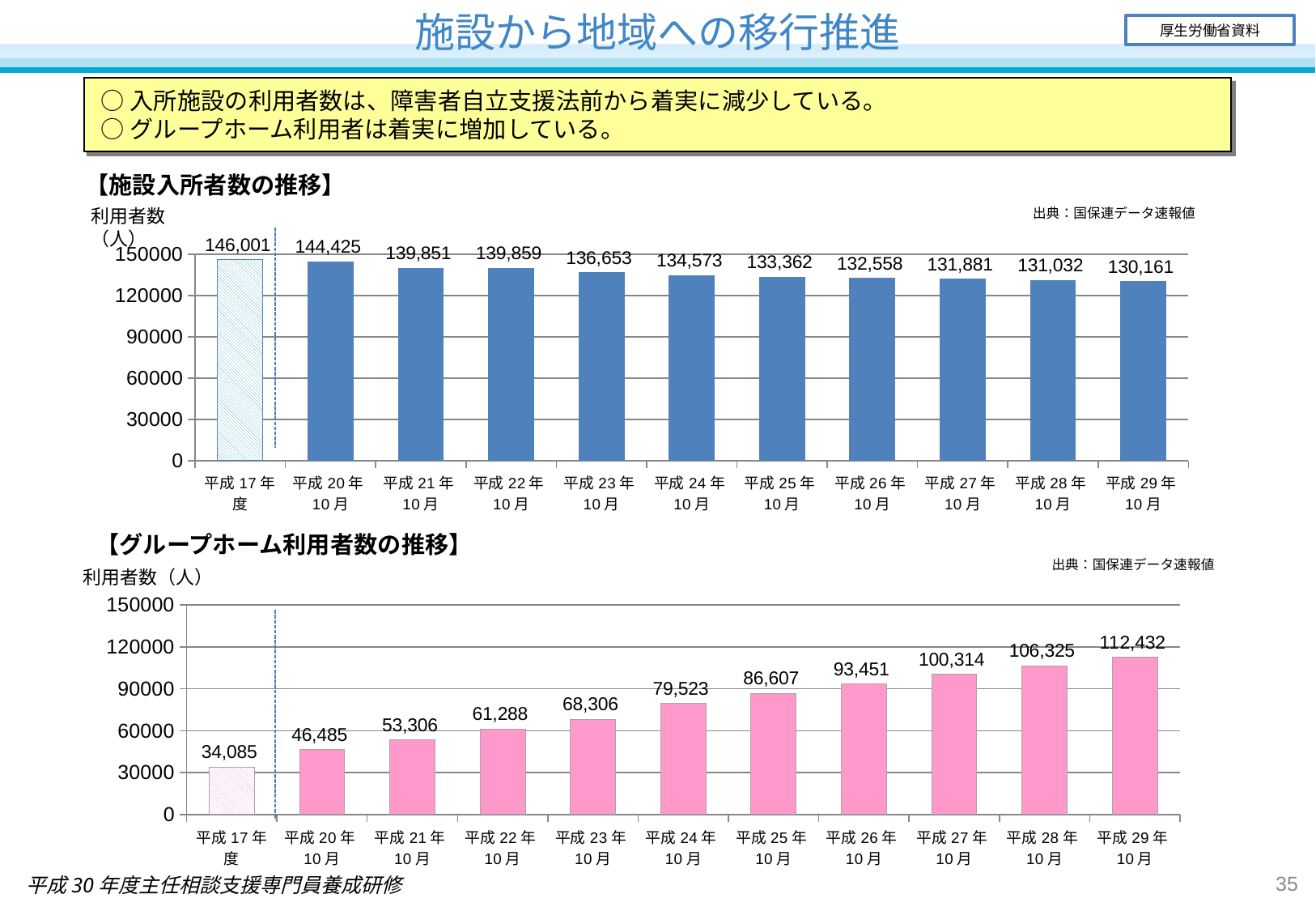
What kind of chart is the 【グループホーム利用者数の推移】 chart? bar chart In the 【施設入所者数の推移】 chart, what is the value for 平成17年度? 146,001 In the 【グループホーム利用者数の推移】 chart, what is the difference between the values for 平成29年10月 and 平成28年10月? 6,107 In the 【施設入所者数の推移】 chart, what is the difference between the values for 平成17年度 and 平成29年10月? 15,840 In the 【グループホーム利用者数の推移】 chart, what is the value for 平成24年10月? 79,523 In the 【グループホーム利用者数の推移】 chart, how many categories are plotted? 11 In the 【グループホーム利用者数の推移】 chart, do the values rise or fall from 平成17年度 to 平成29年10月? rise In the 【施設入所者数の推移】 chart, what is the value for 平成29年10月? 130,161 In the 【施設入所者数の推移】 chart, do the values rise or fall from 平成20年10月 to 平成29年10月? fall In the 【グループホーム利用者数の推移】 chart, which is larger, the value for 平成22年10月 or 平成26年10月? 平成26年10月 In the 【グループホーム利用者数の推移】 chart, which category has the highest value? 平成29年10月 In the 【施設入所者数の推移】 chart, which category has the lowest value? 平成29年10月